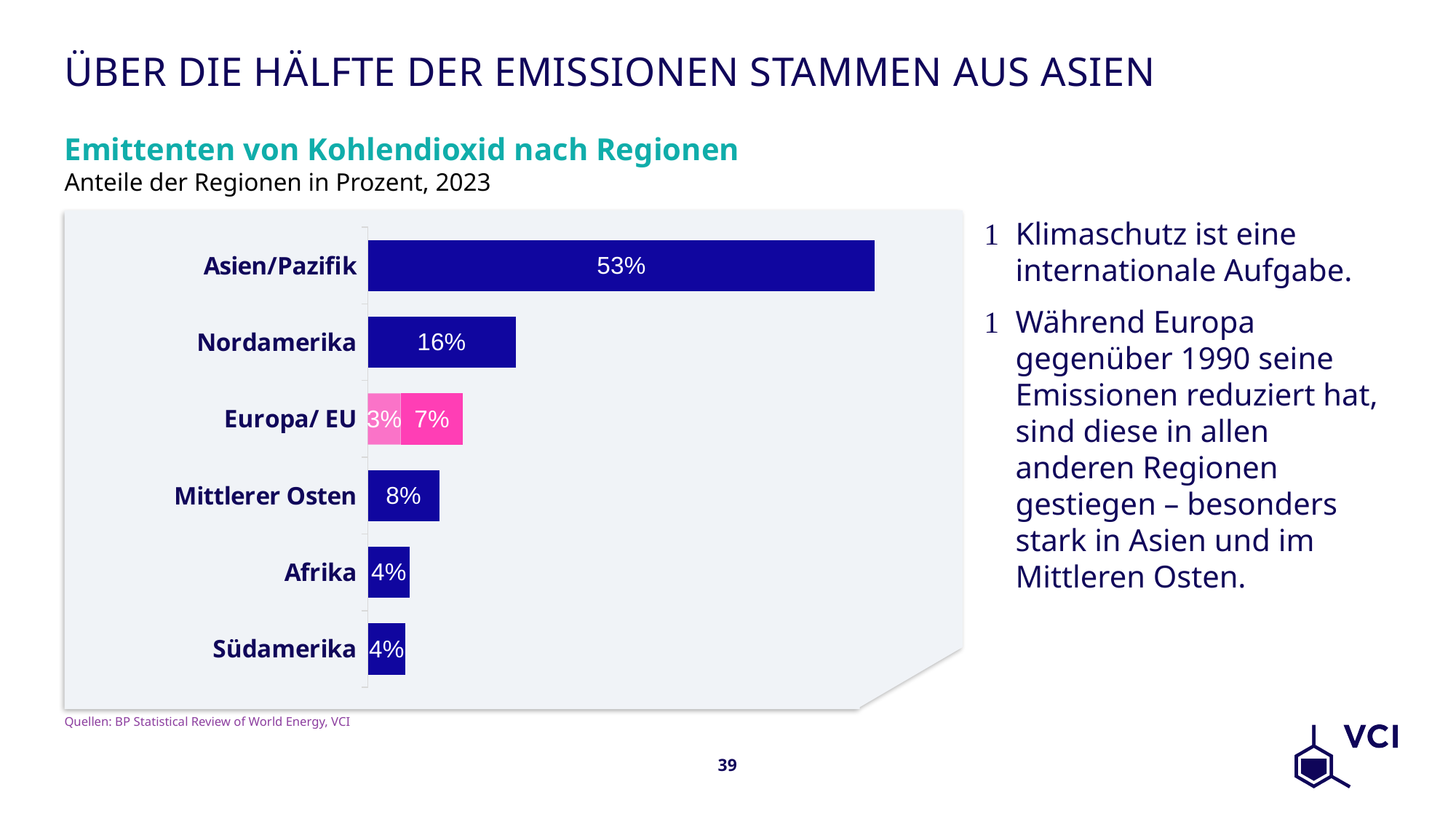
What is the total of the two segments of the Europa/ EU bar? 10% Which is larger, the value for Mittlerer Osten or the value for Afrika? Mittlerer Osten What kind of chart is shown on the slide? Bar chart What is the difference between the values for Nordamerika and Mittlerer Osten? 8 percentage points What is the value for Asien/Pazifik? 53% Which region has the highest share? Asien/Pazifik What is the title of the chart? Emittenten von Kohlendioxid nach Regionen What is the value for Afrika? 4% What is the value for Nordamerika? 16% How many regions are shown in the chart? 6 What is the difference between the values for Asien/Pazifik and Nordamerika? 37 percentage points What is the value for Mittlerer Osten? 8%